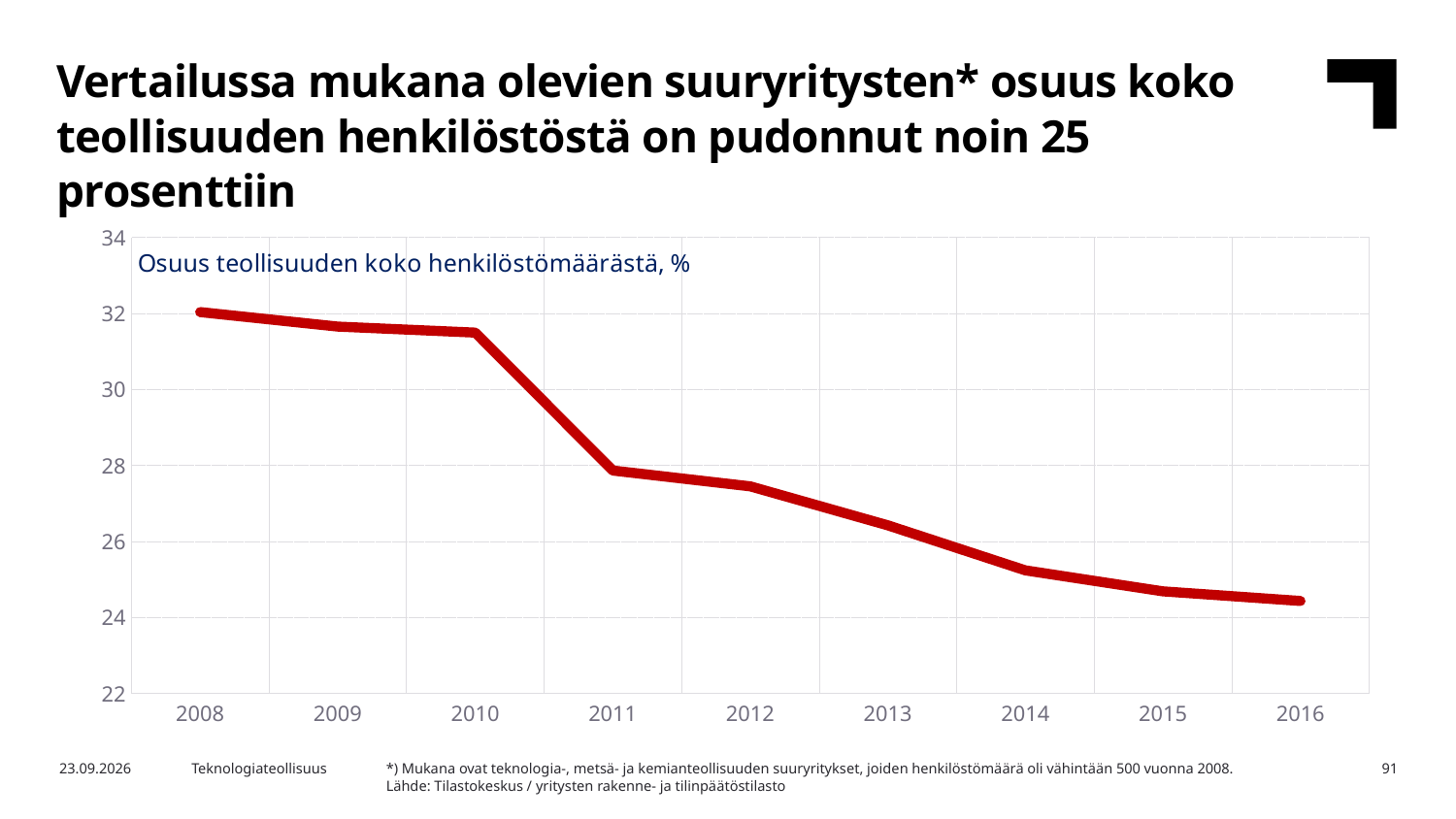
Is the value for 2008 greater or less than 30? greater Is the value for 2012 greater or less than 28? less Which year has the highest value in the chart? 2008 What is the title shown inside the chart area? Osuus teollisuuden koko henkilöstömäärästä, % Which year has the larger value, 2010 or 2011? 2010 Do the values in the chart rise or fall from 2008 to 2016? fall Which year has the larger value, 2013 or 2015? 2013 What kind of chart is shown on the slide? line chart Which year has the lowest value in the chart? 2016 Is the value for 2014 greater or less than 26? less How many years are plotted on the x axis of the chart? 9